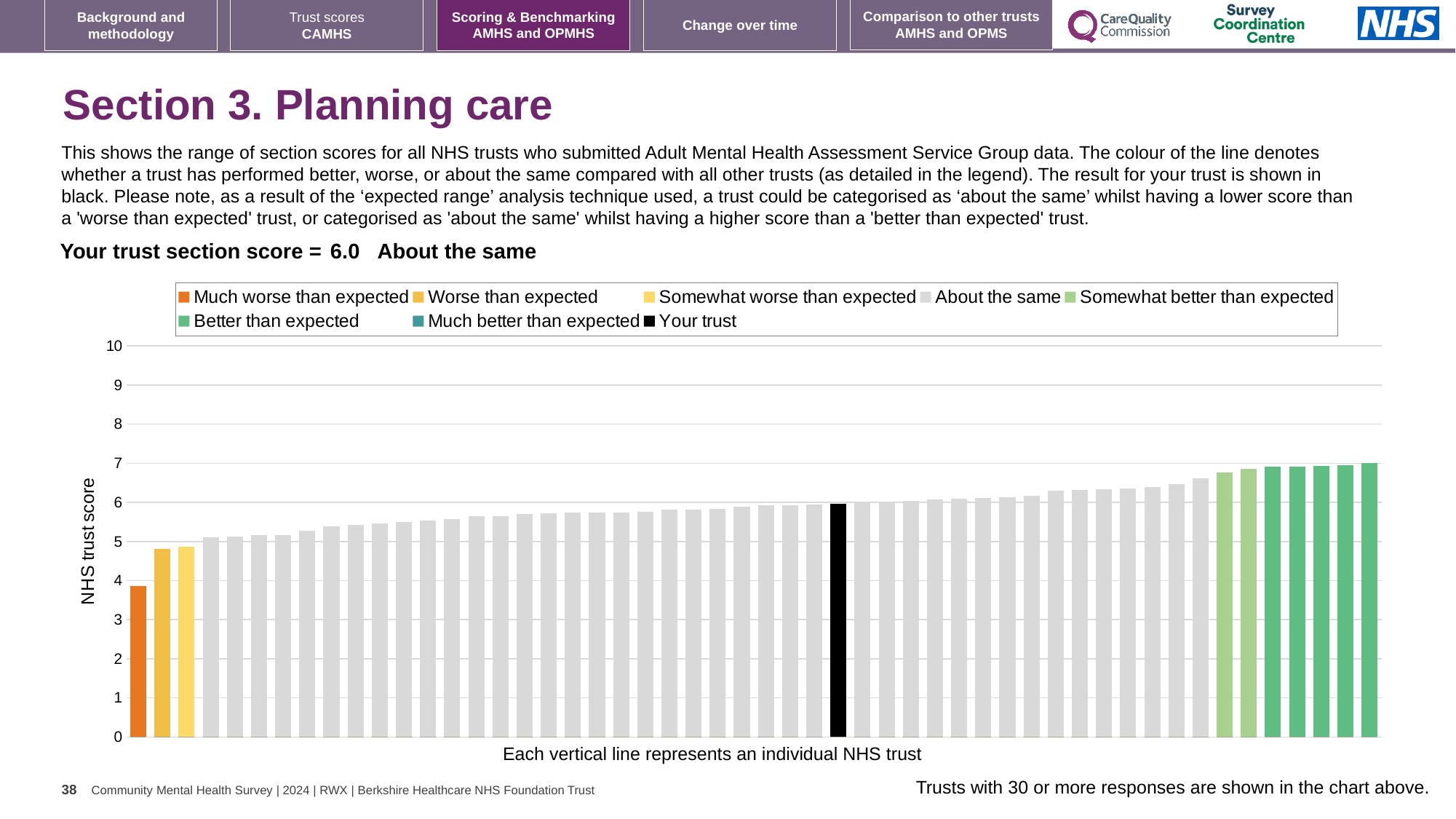
Is the value of the black 'Your trust' bar greater or less than 5? greater How many bars are coloured orange ('Much worse than expected')? 1 How many bars are coloured dark green ('Better than expected')? 5 What is the label on the vertical axis of the chart? NHS trust score What kind of chart is shown on the slide? bar chart Is the value of the leftmost (orange) bar greater or less than 5? less Is the value of the tallest bar greater or less than 8? less Do the bar values rise or fall from left to right across the chart? rise What colour is the bar representing your trust? black Which category does your trust fall into according to the slide? About the same How many entries does the chart legend list? 8 What is the section score for your trust shown on the slide? 6.0